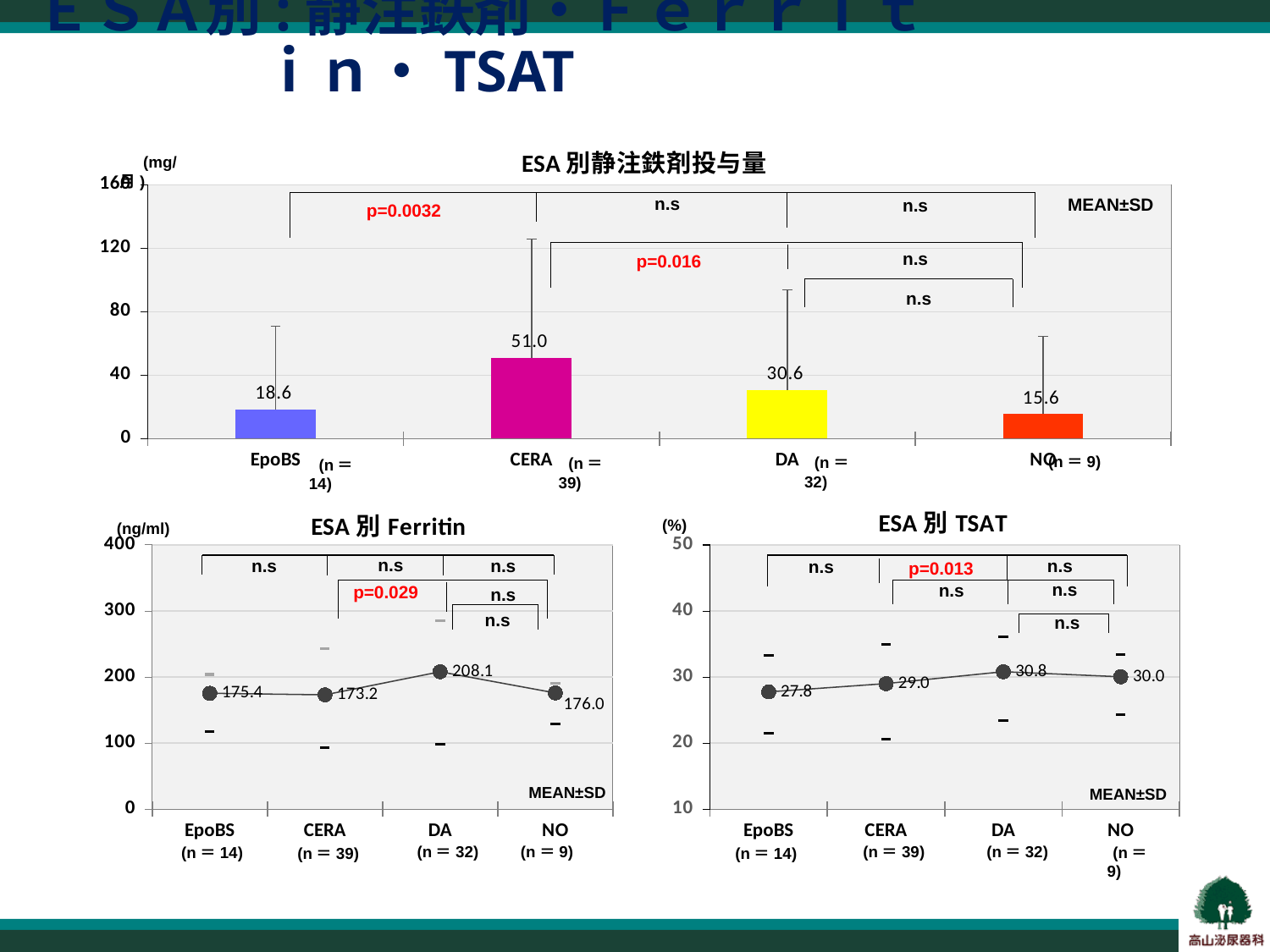
In the top chart titled ESA別静注鉄剤投与量, what is the value for CERA? 51.0 In the bottom-left chart titled ESA別Ferritin, what is the value for DA? 208.1 In the top chart titled ESA別静注鉄剤投与量, which category has the highest value? CERA In the bottom-left chart titled ESA別Ferritin, which category has the highest value? DA In the top chart titled ESA別静注鉄剤投与量, which category has the lowest value? NO In the bottom-left chart titled ESA別Ferritin, what is the difference between the values for DA and CERA? 34.9 In the bottom-right chart titled ESA別TSAT, which is larger, the value for CERA or the value for DA? DA In the top chart titled ESA別静注鉄剤投与量, what is the difference between the values for CERA and DA? 20.4 In the top chart titled ESA別静注鉄剤投与量, how many categories are shown on the x axis? 4 In the top chart titled ESA別静注鉄剤投与量, what kind of chart is used? bar chart In the bottom-right chart titled ESA別TSAT, what unit is shown on the y axis? % In the bottom-right chart titled ESA別TSAT, what is the value for EpoBS? 27.8